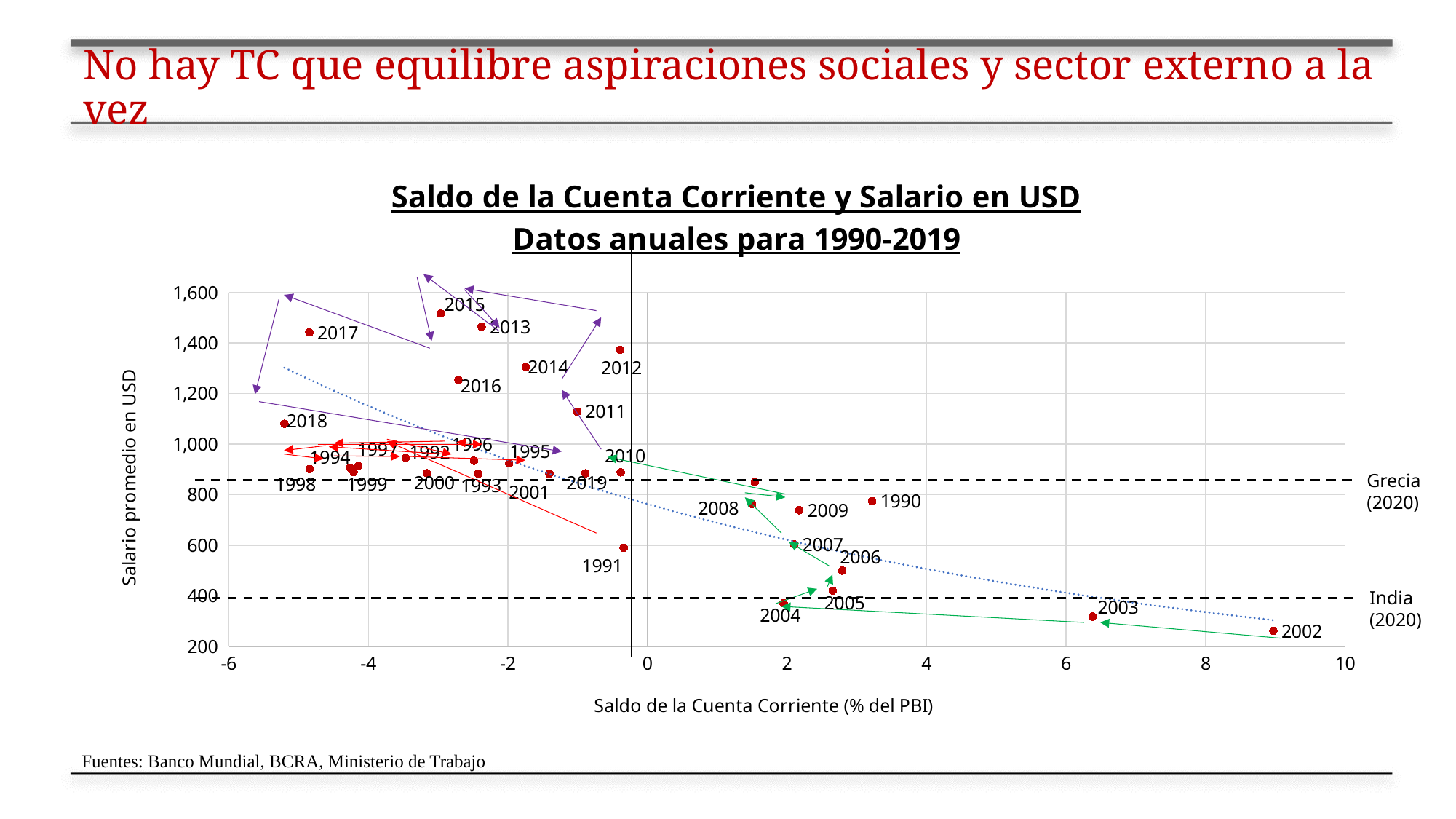
Is the current account balance for 2017 greater or less than -4? less What is the label of the vertical axis? Salario promedio en USD Is the average salary for 1991 greater or less than 800? less What is the title of the chart? Saldo de la Cuenta Corriente y Salario en USD, Datos anuales para 1990-2019 Is the current account balance for 2002 greater or less than 8? greater Which year has the larger current account balance, 2002 or 2004? 2002 Which year has the highest current account balance (% of GDP)? 2002 What kind of chart is shown on the slide? scatter chart Which year has the lowest average salary in USD? 2002 Which year has the higher average salary, 2017 or 2016? 2017